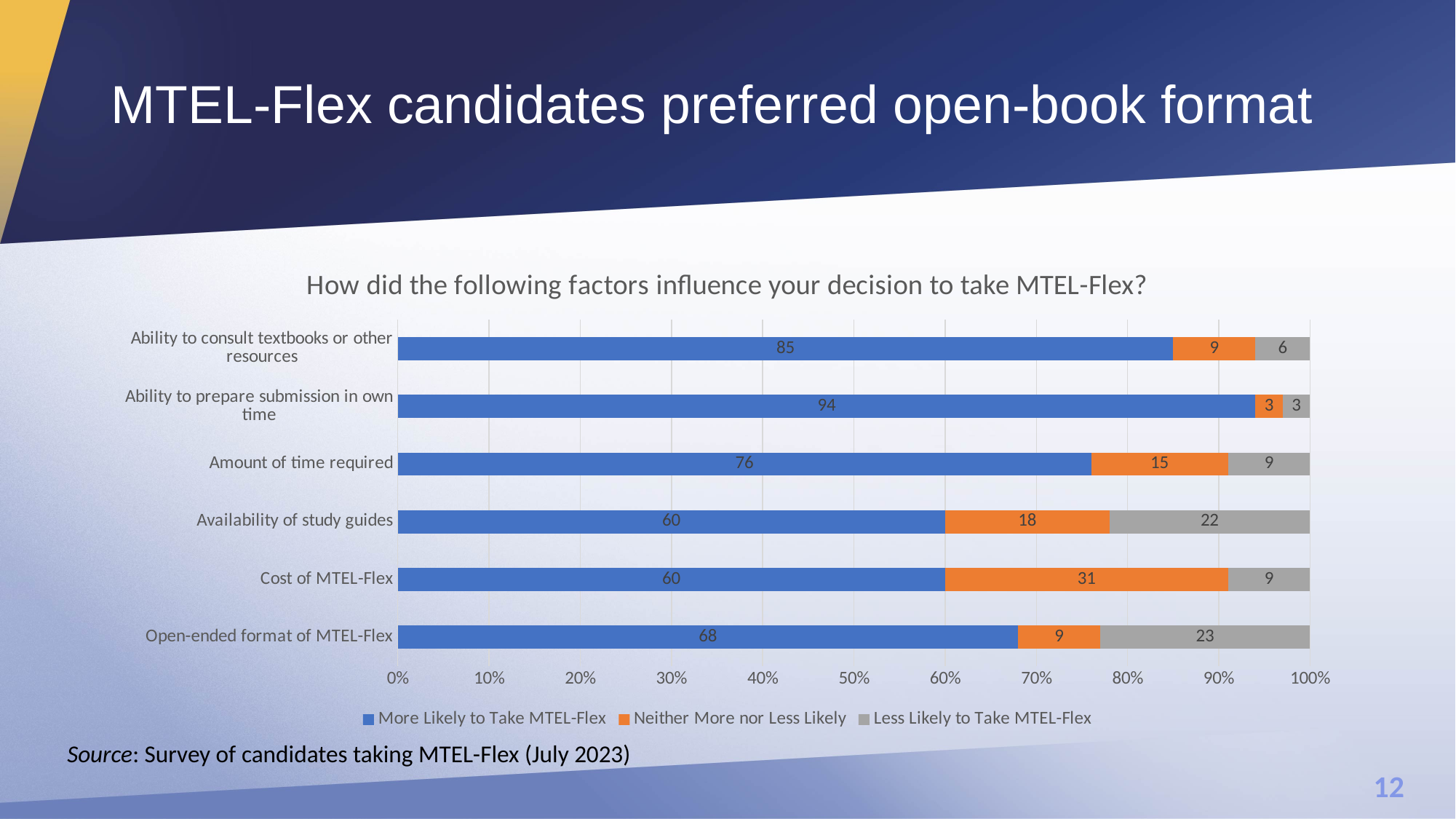
What kind of chart is shown on the slide? Stacked bar chart What is the value for "Neither More nor Less Likely" for "Cost of MTEL-Flex"? 31 How many series does the legend list? 3 Which is larger: the "Less Likely to Take MTEL-Flex" value for "Availability of study guides" or for "Amount of time required"? Availability of study guides What is the title of the chart? How did the following factors influence your decision to take MTEL-Flex? Which category has the lowest value for "Less Likely to Take MTEL-Flex"? Ability to prepare submission in own time What is the difference between the "More Likely to Take MTEL-Flex" values for "Ability to consult textbooks or other resources" and "Amount of time required"? 9 What is the value for "More Likely to Take MTEL-Flex" for "Ability to prepare submission in own time"? 94 What is the total of the stacked bar for "Availability of study guides"? 100 Which category has the highest value for "More Likely to Take MTEL-Flex"? Ability to prepare submission in own time How many categories are shown on the chart? 6 What is the value for "Less Likely to Take MTEL-Flex" for "Open-ended format of MTEL-Flex"? 23